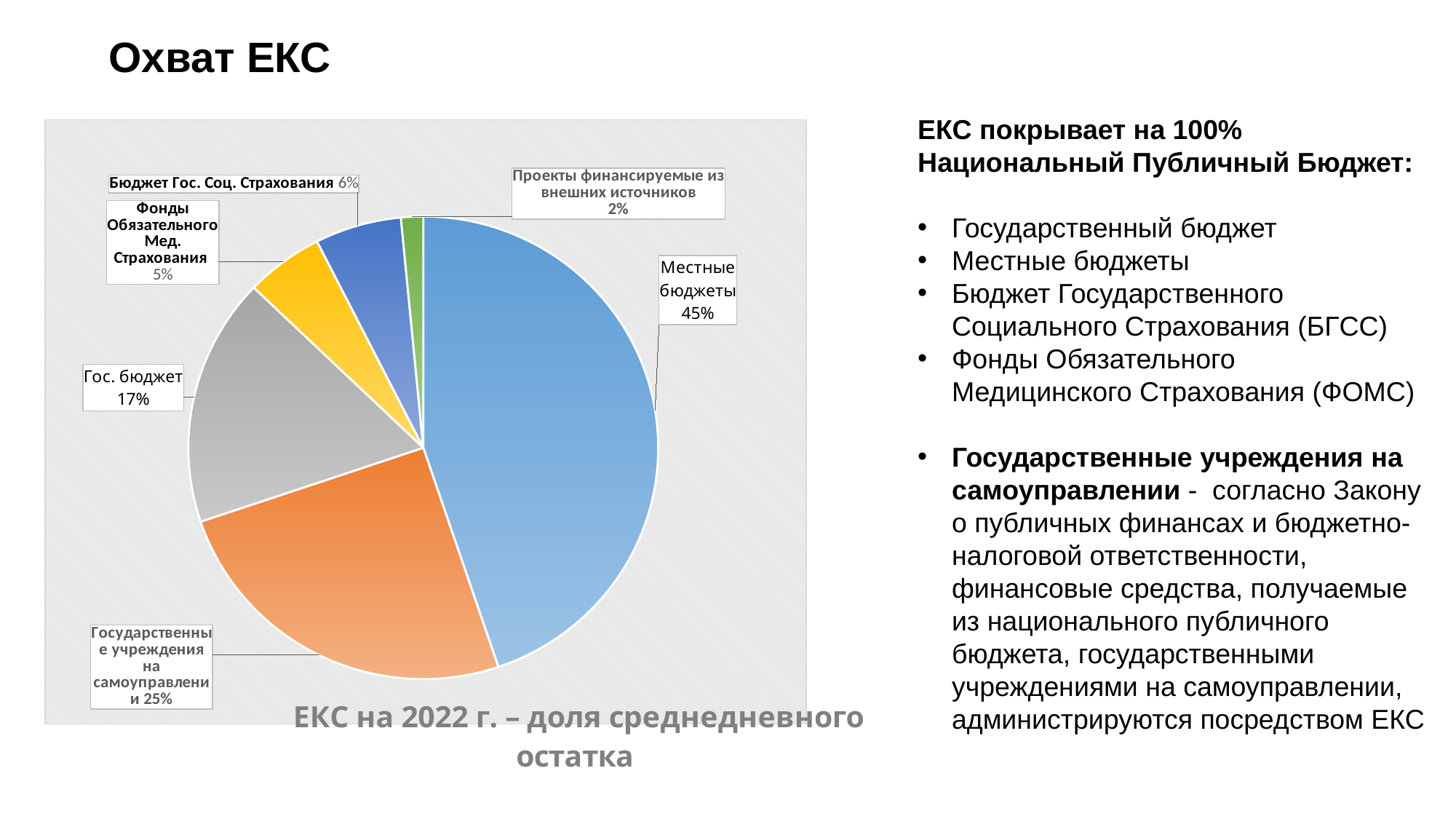
What is the difference in percentage points between Местные бюджеты and Гос. бюджет? 28 How many slices does the pie chart have? 6 What is the share for Местные бюджеты in the pie chart? 45% What type of chart is shown on the slide? pie chart Which category has the smallest slice in the pie chart? Проекты финансируемые из внешних источников What is the share for Гос. бюджет in the pie chart? 17% Which is larger: Бюджет Гос. Соц. Страхования or Фонды Обязательного Мед. Страхования? Бюджет Гос. Соц. Страхования Which category has the largest slice in the pie chart? Местные бюджеты What is the share for Проекты финансируемые из внешних источников? 2% What is the share for Государственные учреждения на самоуправлении? 25% What is the title of the pie chart? ЕКС на 2022 г. – доля среднедневного остатка What is the share for Фонды Обязательного Мед. Страхования? 5%